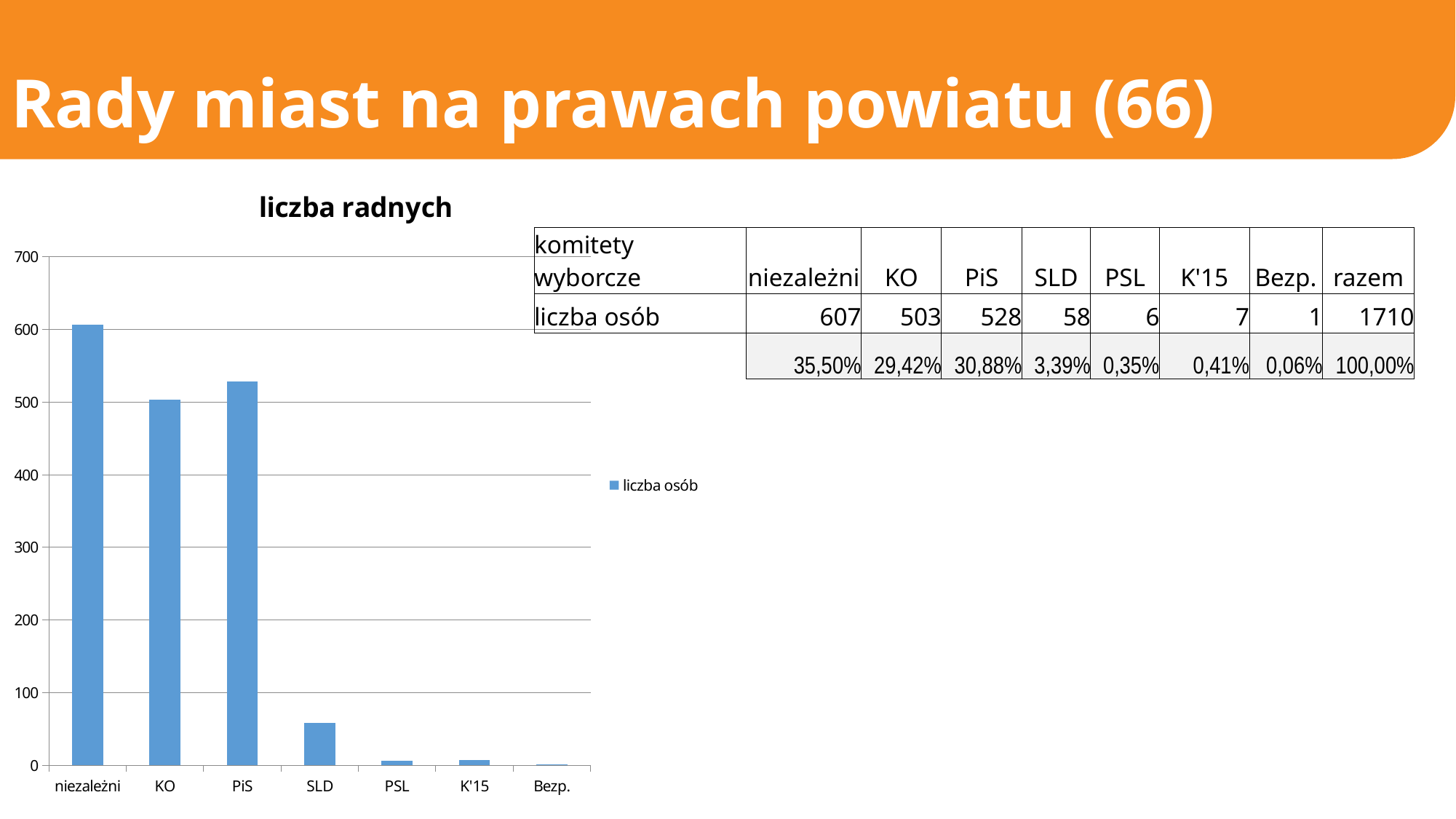
What is the difference between the values for niezależni and PiS? 79 How many categories are shown on the x axis of the chart? 7 Is the bar for SLD greater or less than 100? less Which bar is taller, PiS or KO? PiS Which category has the lowest bar in the chart? Bezp. Is the bar for KO greater or less than 500? greater What is the title of the chart? liczba radnych How many series does the chart legend list? 1 What is the name of the series shown in the legend? liczba osób What is the value for niezależni in the chart? 607 What kind of chart is shown on the slide? bar chart Which category has the highest bar in the chart? niezależni